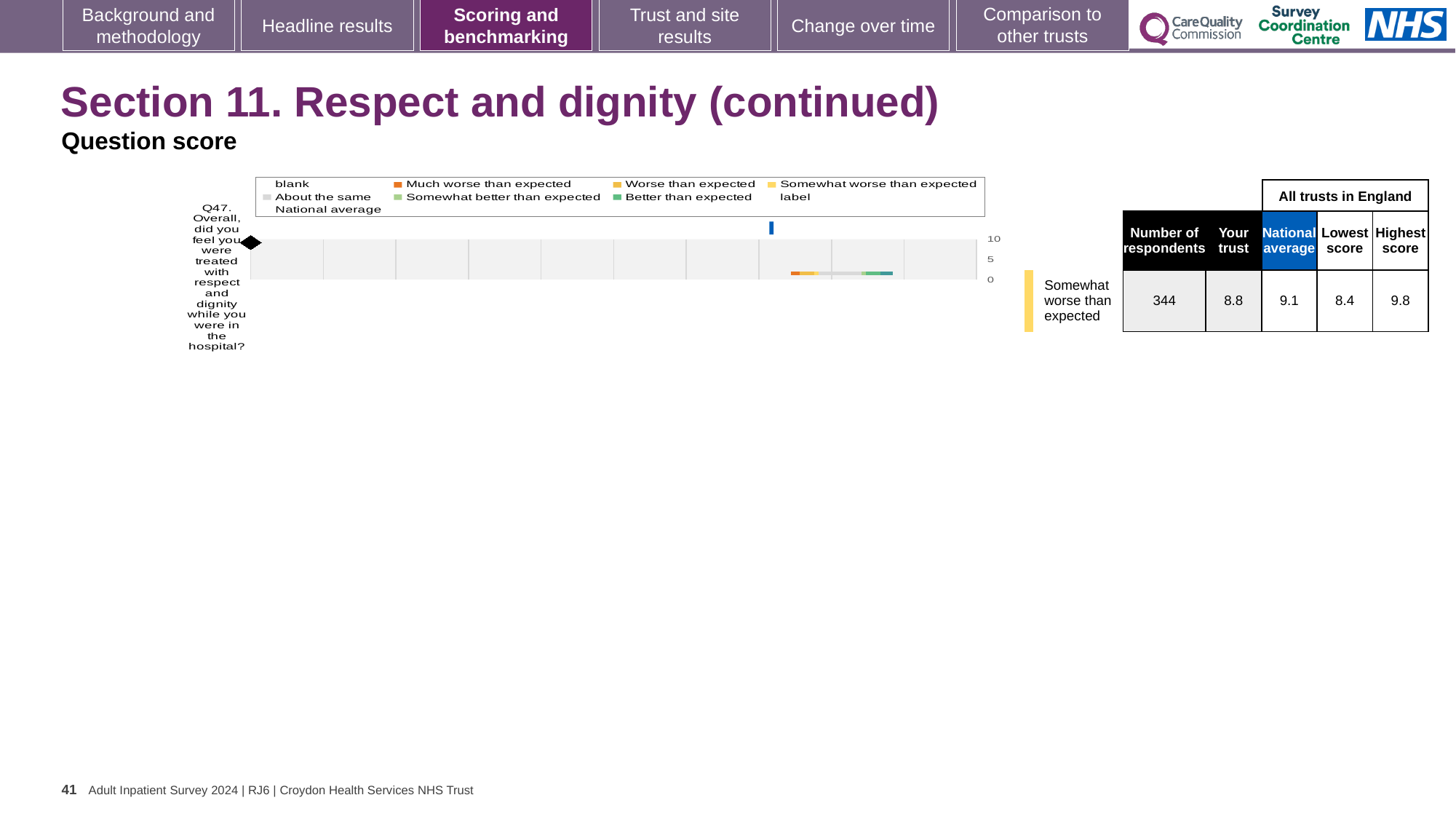
Is the 'Your trust' score for Q47 greater or less than 5 on the chart axis? greater How many survey questions are plotted in the chart? 1 Which is larger for Q47, the 'Your trust' score or the national average? National average Which benchmarking category is the trust's Q47 score assigned to? Somewhat worse than expected How many respondents answered Q47? 344 What is the lowest score among all trusts in England for Q47? 8.4 What is the highest tick value shown on the chart's score axis? 10 What kind of chart is shown for Q47 on this slide? bar chart What is the national average score for Q47? 9.1 What is the highest score among all trusts in England for Q47? 9.8 What is the 'Your trust' score for Q47? 8.8 What is the difference between the highest score and the lowest score for Q47? 1.4